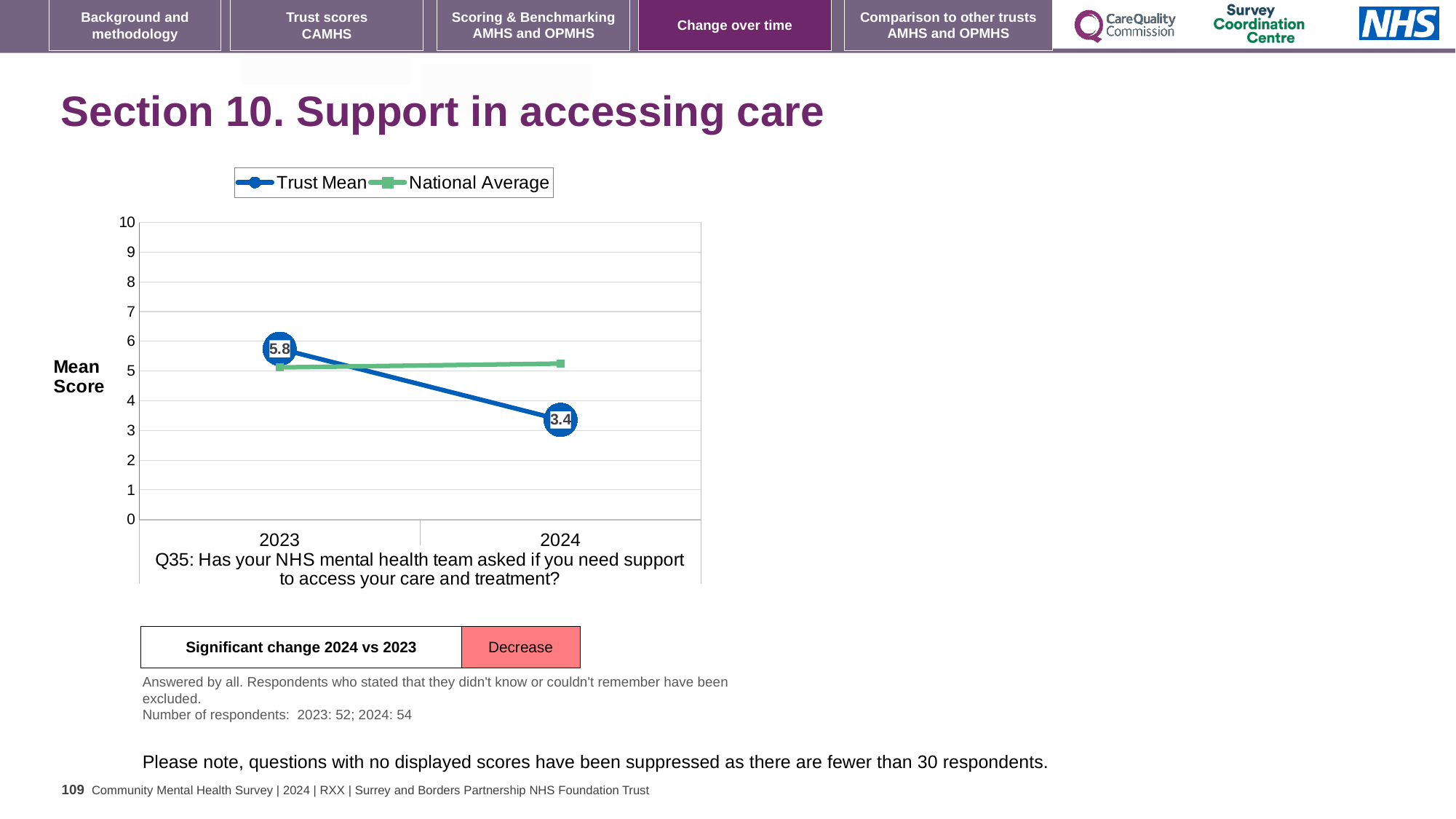
In 2023, which is larger: the Trust Mean or the National Average? Trust Mean In 2024, which is larger: the Trust Mean or the National Average? National Average What kind of chart is shown on the slide? line chart How many series does the legend list? 2 What is the Trust Mean score for 2024? 3.4 In which year was the Trust Mean score higher? 2023 What is the significant change for 2024 vs 2023 shown below the chart? Decrease Does the Trust Mean rise or fall from 2023 to 2024? fall By how much did the Trust Mean score change from 2023 to 2024? 2.4 Is the National Average value for 2024 greater or less than 6? less In which year was the Trust Mean score lower? 2024 What is the Trust Mean score for 2023? 5.8